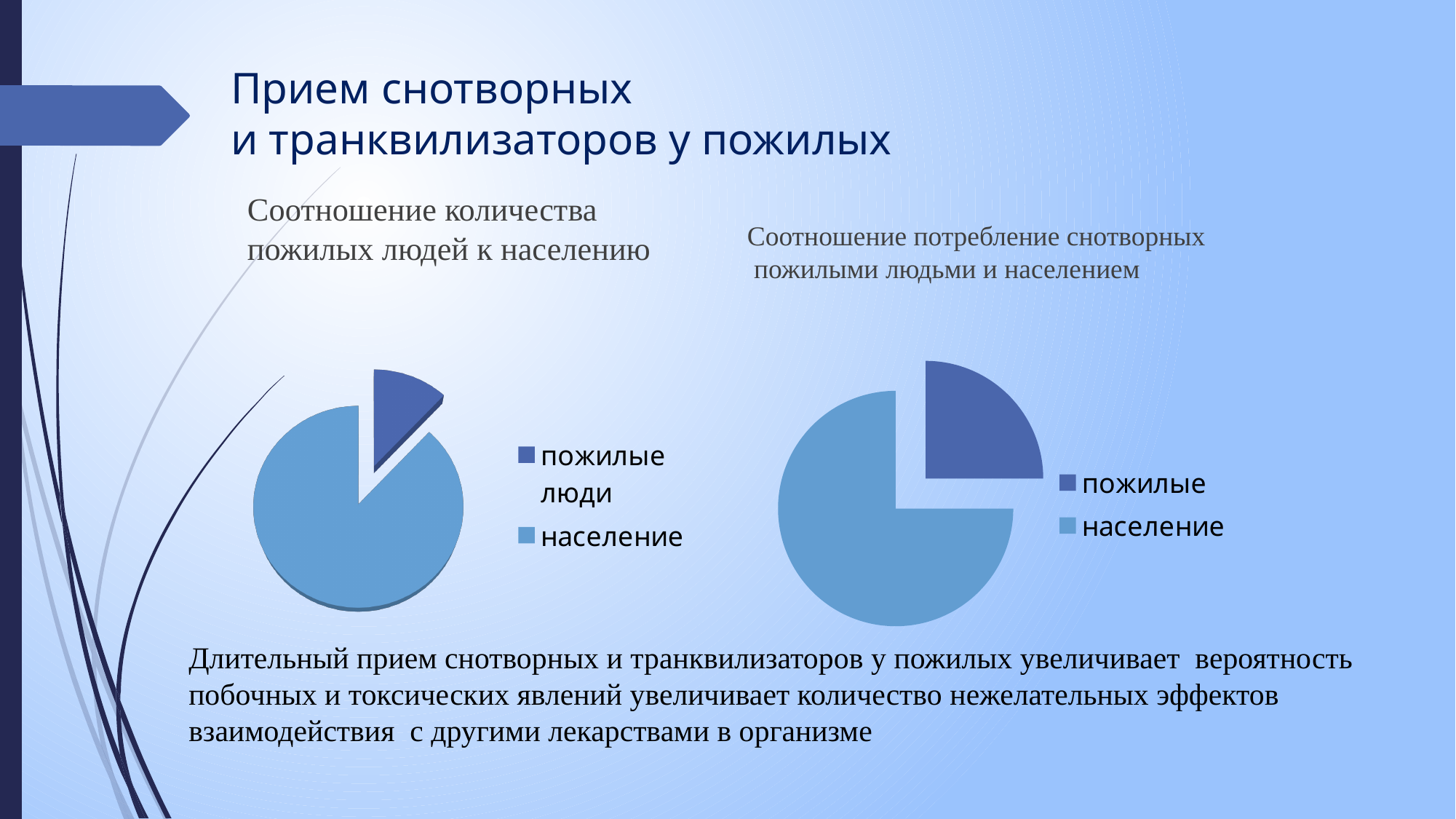
In the left chart ("Соотношение количества пожилых людей к населению"), which category has the smallest slice? пожилые люди What is the title of the left pie chart on the slide? Соотношение количества пожилых людей к населению In the left chart ("Соотношение количества пожилых людей к населению"), how many slices does the pie have? 2 In the left chart ("Соотношение количества пожилых людей к населению"), which category has the largest slice? население In the right chart ("Соотношение потребление снотворных пожилыми людьми и населением"), which category has the largest slice? население What kind of chart is the left chart titled "Соотношение количества пожилых людей к населению"? pie chart How many entries does the legend of the right chart ("Соотношение потребление снотворных пожилыми людьми и населением") list? 2 What kind of chart is the right chart titled "Соотношение потребление снотворных пожилыми людьми и населением"? pie chart In the right chart ("Соотношение потребление снотворных пожилыми людьми и населением"), which slice is larger: пожилые or население? население In the right chart ("Соотношение потребление снотворных пожилыми людьми и населением"), which category has the smallest slice? пожилые In the left chart ("Соотношение количества пожилых людей к населению"), which slice is larger: пожилые люди or население? население In the right chart ("Соотношение потребление снотворных пожилыми людьми и населением"), how many slices does the pie have? 2